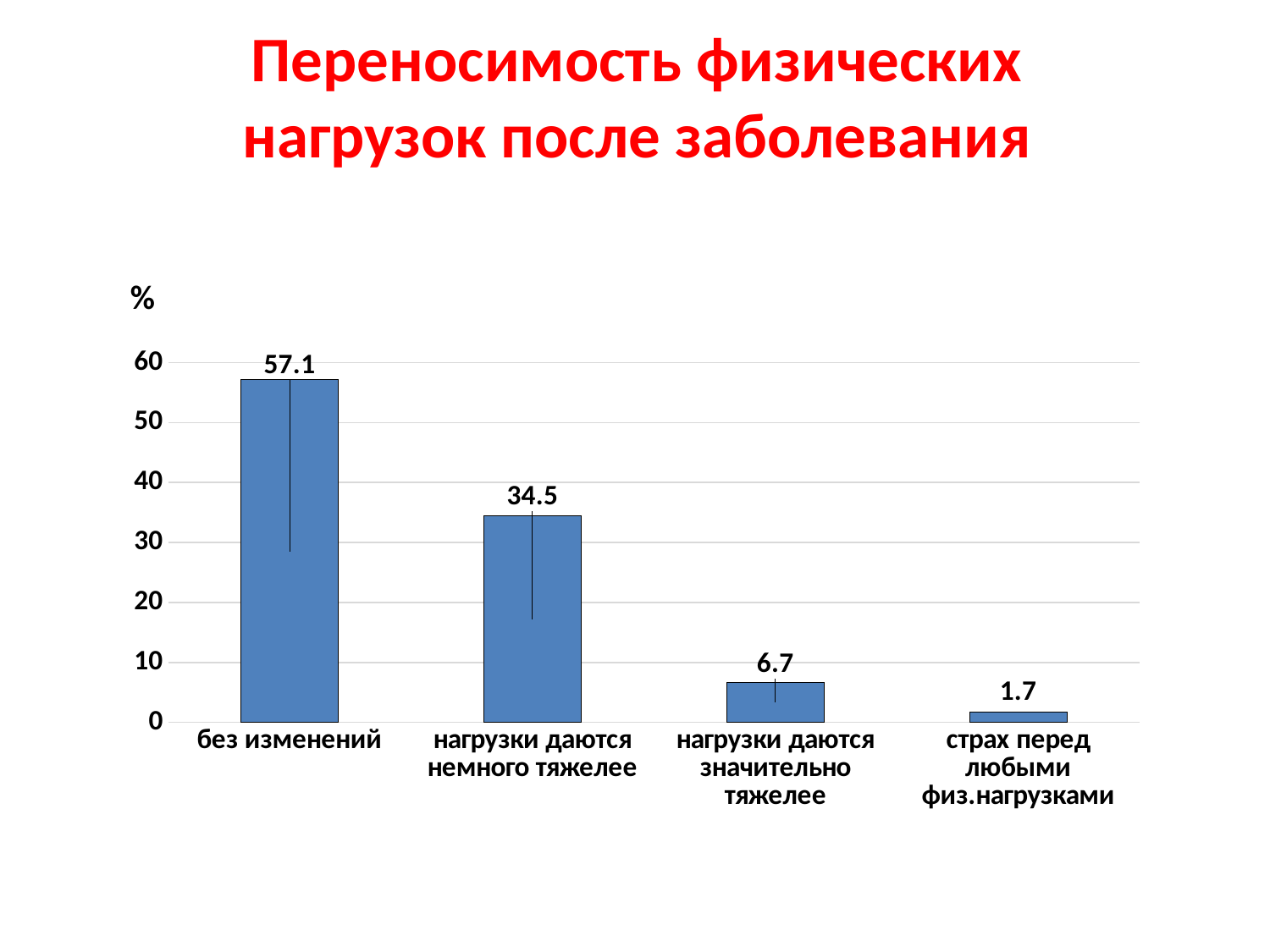
Which category has the highest value? без изменений Is the value for "нагрузки даются немного тяжелее" greater or less than 40? less What is the value for "нагрузки даются немного тяжелее"? 34.5 What is the difference between the values for "без изменений" and "нагрузки даются немного тяжелее"? 22.6 What is the value for "без изменений"? 57.1 What kind of chart is shown on the slide? bar chart Which category has the lowest value? страх перед любыми физ.нагрузками What is the value for "нагрузки даются значительно тяжелее"? 6.7 What is the title of the slide? Переносимость физических нагрузок после заболевания What is the value for "страх перед любыми физ.нагрузками"? 1.7 How many categories are shown on the chart? 4 Which is larger: the value for "нагрузки даются значительно тяжелее" or for "страх перед любыми физ.нагрузками"? нагрузки даются значительно тяжелее